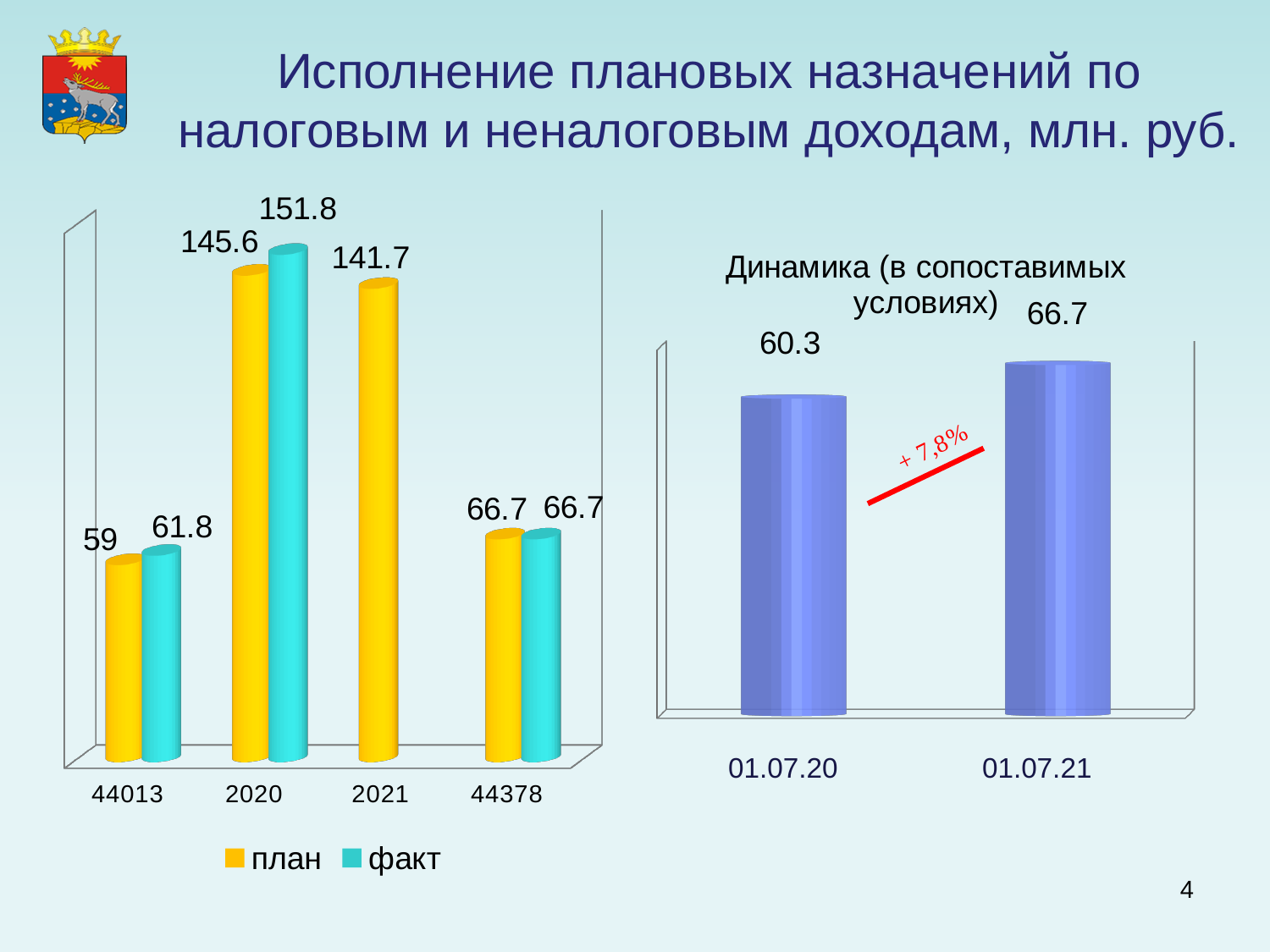
In the left chart, which category has the highest факт value? 2020 In the left chart, what is the факт value for category 44013? 61.8 In the left chart, what is the difference between the факт and план values for category 2020? 6.2 In the left chart, what is the план value for category 2021? 141.7 In the chart titled 'Динамика (в сопоставимых условиях)', what is the difference between the values for 01.07.21 and 01.07.20? 6.4 What type of chart is the left chart? bar chart In the left chart, which category has the lowest план value? 44013 In the chart titled 'Динамика (в сопоставимых условиях)', what percentage change is shown by the red annotation? + 7,8% In the left chart, which is larger for category 44013: план or факт? факт How many series does the legend of the left chart list? 2 In the left chart, what is the план value for category 2020? 145.6 In the chart titled 'Динамика (в сопоставимых условиях)', what is the value for 01.07.21? 66.7